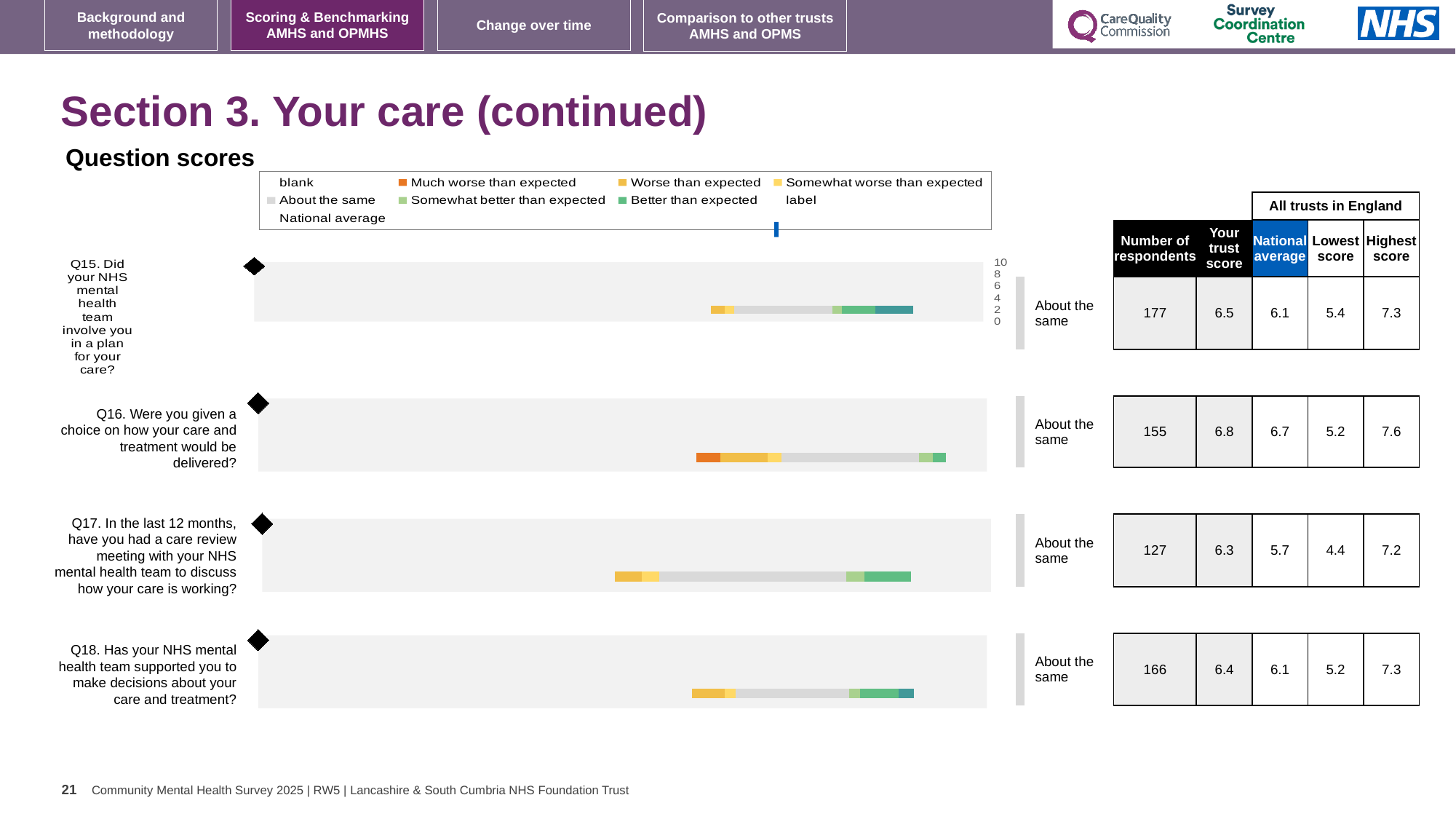
For the Q17 chart, what is the difference between the trust score and the national average? 0.6 For the Q17 chart, what is the trust score shown in the table? 6.3 What type of chart is used to show the question scores for Q15 to Q18? bar chart For the Q16 chart, what is the number of respondents shown in the table? 155 What category label is shown next to the Q18 chart? About the same Which question (Q15 to Q18) has the highest trust score? Q16 How many question charts (Q15 to Q18) are shown on the slide? 4 Which legend entry is shown in dark orange? Much worse than expected Which question (Q15 to Q18) has the lowest number of respondents? Q17 For the Q15 chart, which is larger: the trust score or the national average? the trust score For the Q15 chart, what is the highest score among all trusts in England? 7.3 For the Q18 chart, what is the national average shown in the table? 6.1